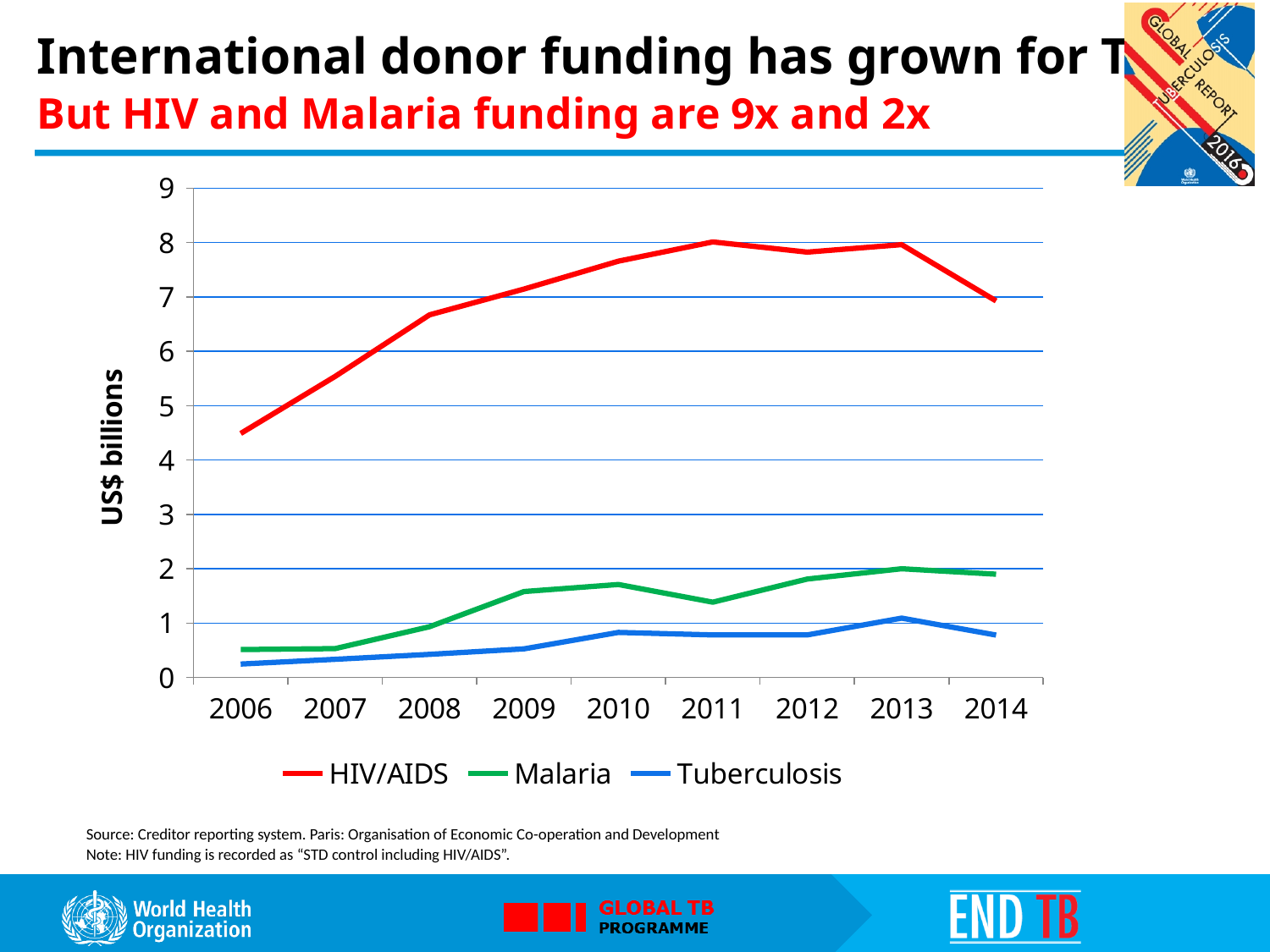
Does the HIV/AIDS line rise or fall from 2006 to 2011? rise In 2014, which is larger: HIV/AIDS or Malaria? HIV/AIDS What kind of chart is shown on the slide? line chart Is the value for Malaria in 2009 greater or less than 1? greater In which year is the Tuberculosis value highest? 2013 How many series does the legend list? 3 Is the value for Tuberculosis in 2010 greater or less than 1? less What is the label on the y axis? US$ billions Is the value for HIV/AIDS in 2006 greater or less than 5? less How many years are shown on the x axis? 9 In which year is the HIV/AIDS value lowest? 2006